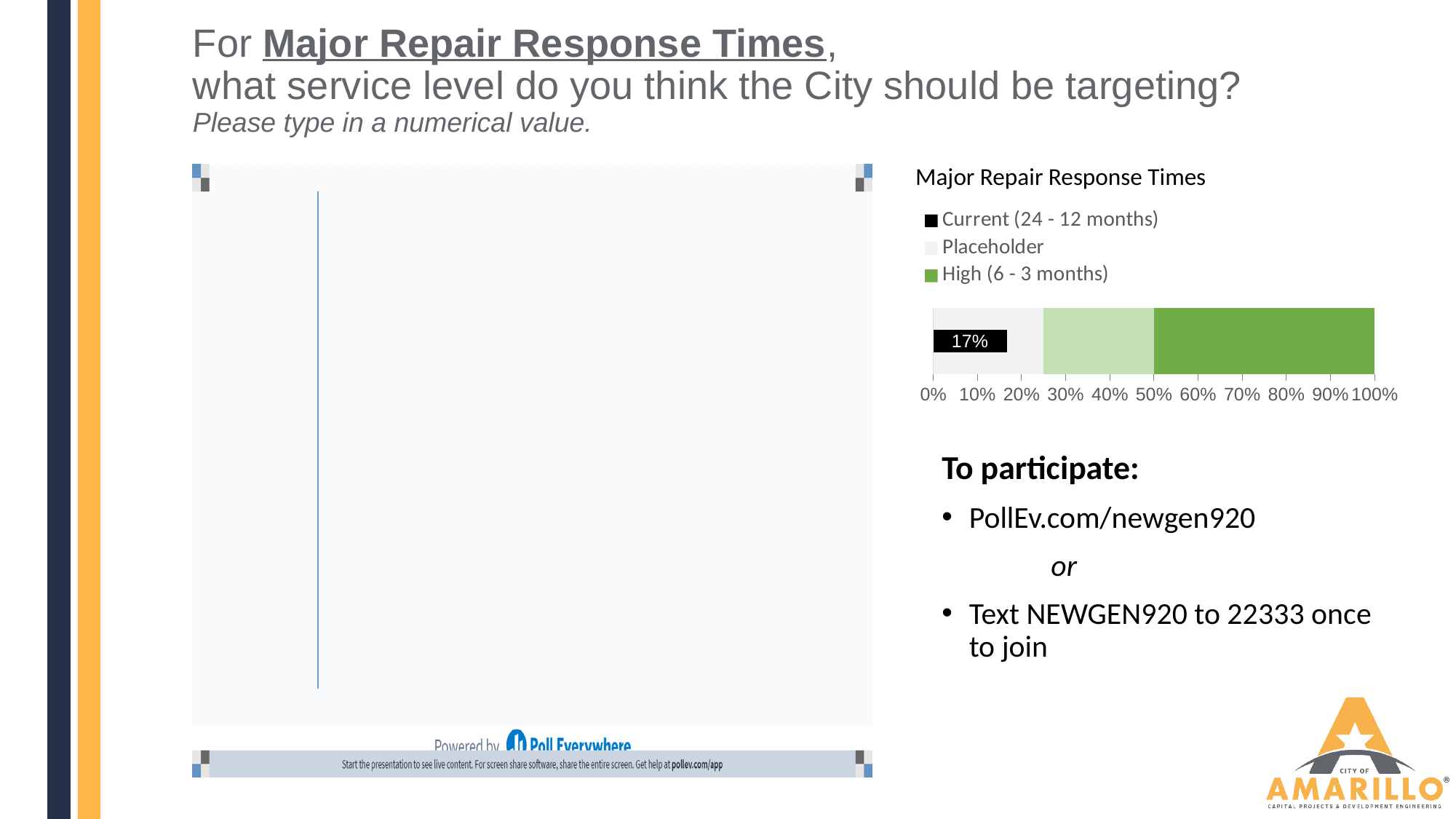
In the Major Repair Response Times chart, what value is printed as a data label on the bar? 17% How many series does the legend of the Major Repair Response Times chart list? 3 In the Major Repair Response Times chart, is the width of the High (6 - 3 months) segment greater or less than 40%? greater In the Major Repair Response Times chart, is the High (6 - 3 months) segment wider or narrower than the Placeholder segment? wider In the Major Repair Response Times chart, which series occupies the widest segment of the stacked bar? High (6 - 3 months) What kind of chart is the Major Repair Response Times chart? bar chart In the Major Repair Response Times chart, which legend entry is shown in green? High (6 - 3 months) What is the title of the chart on the right side of the slide? Major Repair Response Times In the Major Repair Response Times chart, does the right end of the stacked bar reach greater or less than 90% on the axis? greater How many stacked bars are plotted in the Major Repair Response Times chart? 1